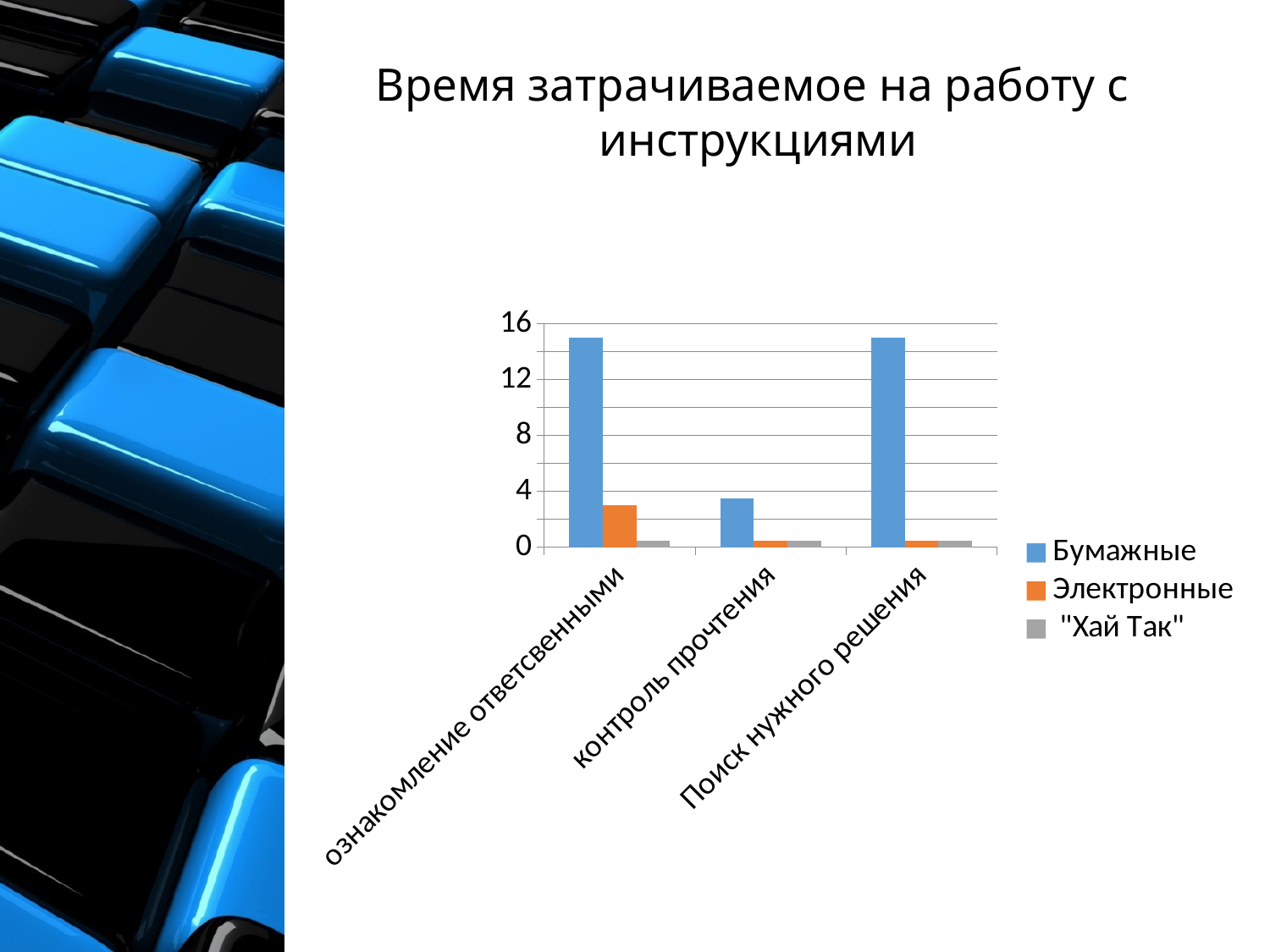
Is the value for Бумажные in the category "контроль прочтения" greater or less than 4? less How many series does the legend list? 3 What is the title of the chart? Время затрачиваемое на работу с инструкциями What kind of chart is shown on the slide? bar chart Is the value for Электронные in the category "ознакомление ответсвенными" greater or less than 4? less Which series has the lowest value in the category "контроль прочтения"? Электронные and "Хай Так" (tied) Is the value for Бумажные in the category "Поиск нужного решения" greater or less than 12? greater Which series is shown in orange? Электронные For the Бумажные series, which category has the lowest value? контроль прочтения In the category "ознакомление ответсвенными", which is larger: the value for Бумажные or the value for Электронные? Бумажные How many categories are shown on the x axis? 3